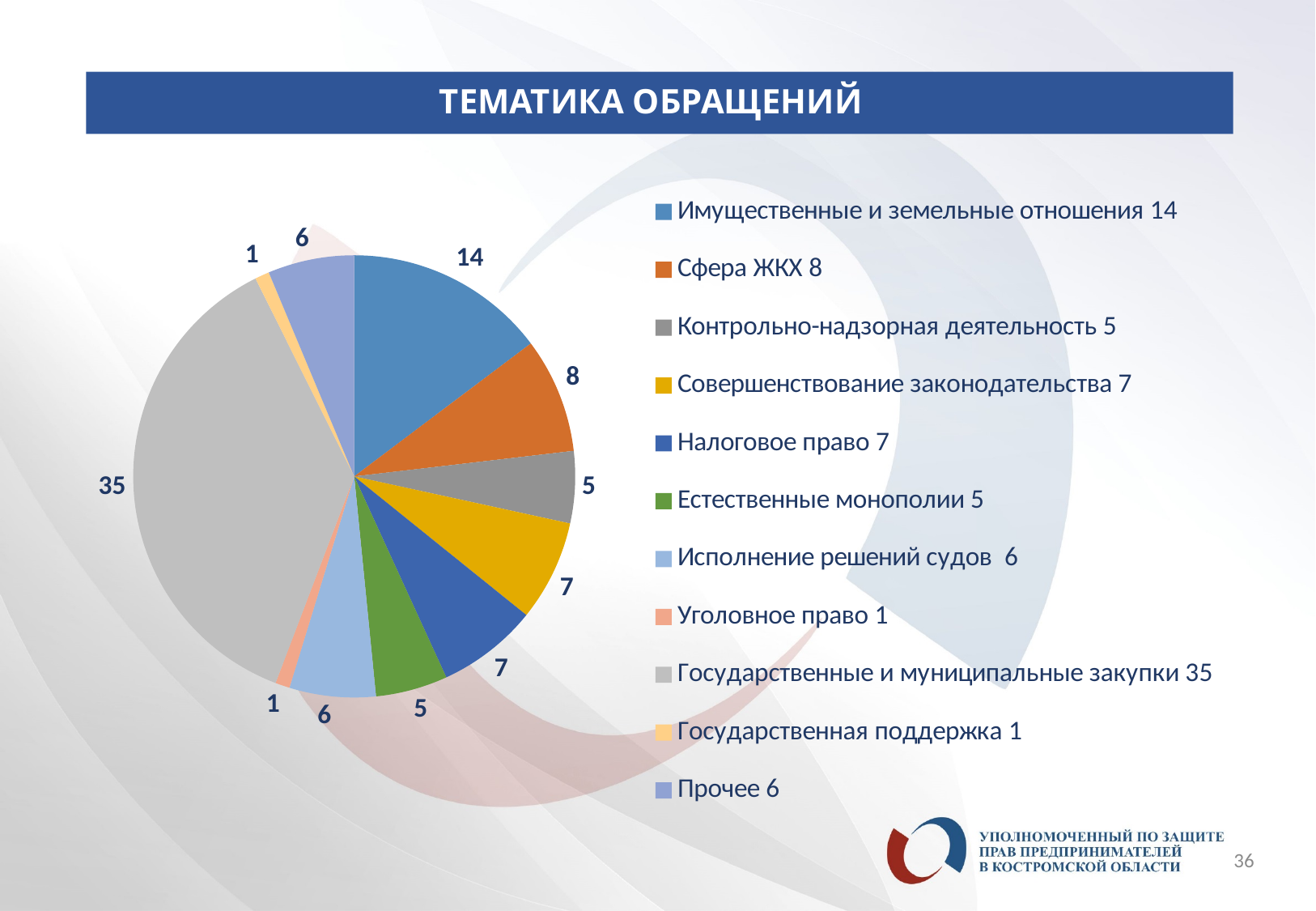
Which category has the largest value? Государственные и муниципальные закупки What is the value for Имущественные и земельные отношения? 14 What is the value for Сфера ЖКХ? 8 What is the value for Государственные и муниципальные закупки? 35 What is the title of the chart? ТЕМАТИКА ОБРАЩЕНИЙ Which is larger, Сфера ЖКХ or Естественные монополии? Сфера ЖКХ What kind of chart is shown on the slide? pie chart What is the value for Исполнение решений судов? 6 What is the total of all values in the pie chart? 95 Which two categories have the smallest value? Уголовное право and Государственная поддержка How many categories does the pie chart have? 11 What is the difference between Государственные и муниципальные закупки and Имущественные и земельные отношения? 21